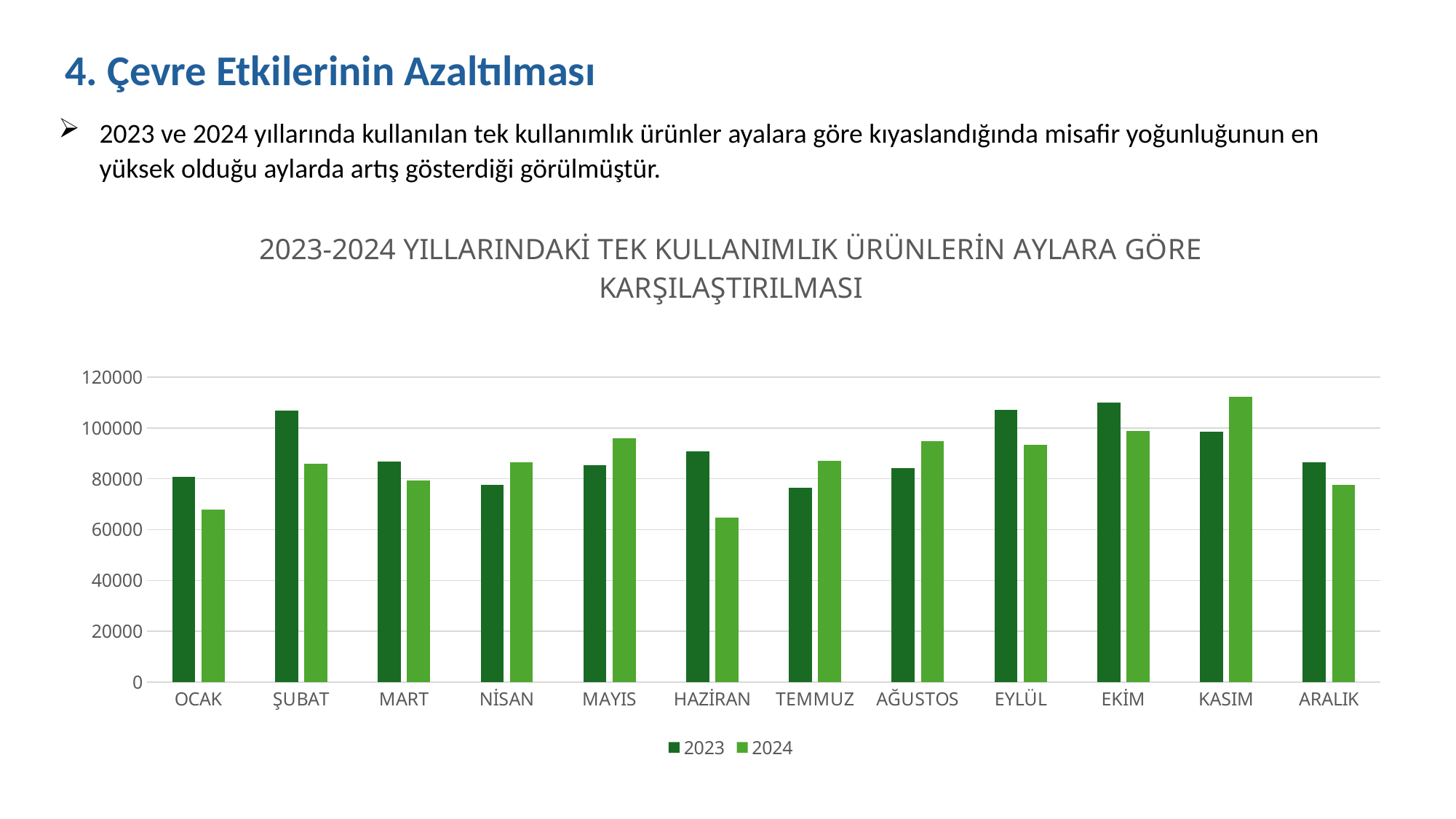
What kind of chart is shown on the slide? bar chart Which month has the highest value for the 2024 series? KASIM What are the two series names shown in the legend? 2023 and 2024 Which month has the highest value for the 2023 series? EKİM Is the 2023 value for ŞUBAT greater or less than 100000? greater How many months are shown on the x axis? 12 For MAYIS, which series has the larger value, 2023 or 2024? 2024 Is the 2024 value for KASIM greater or less than 100000? greater How many series does the legend list? 2 Is the 2024 value for HAZİRAN greater or less than 80000? less For HAZİRAN, which series has the larger value, 2023 or 2024? 2023